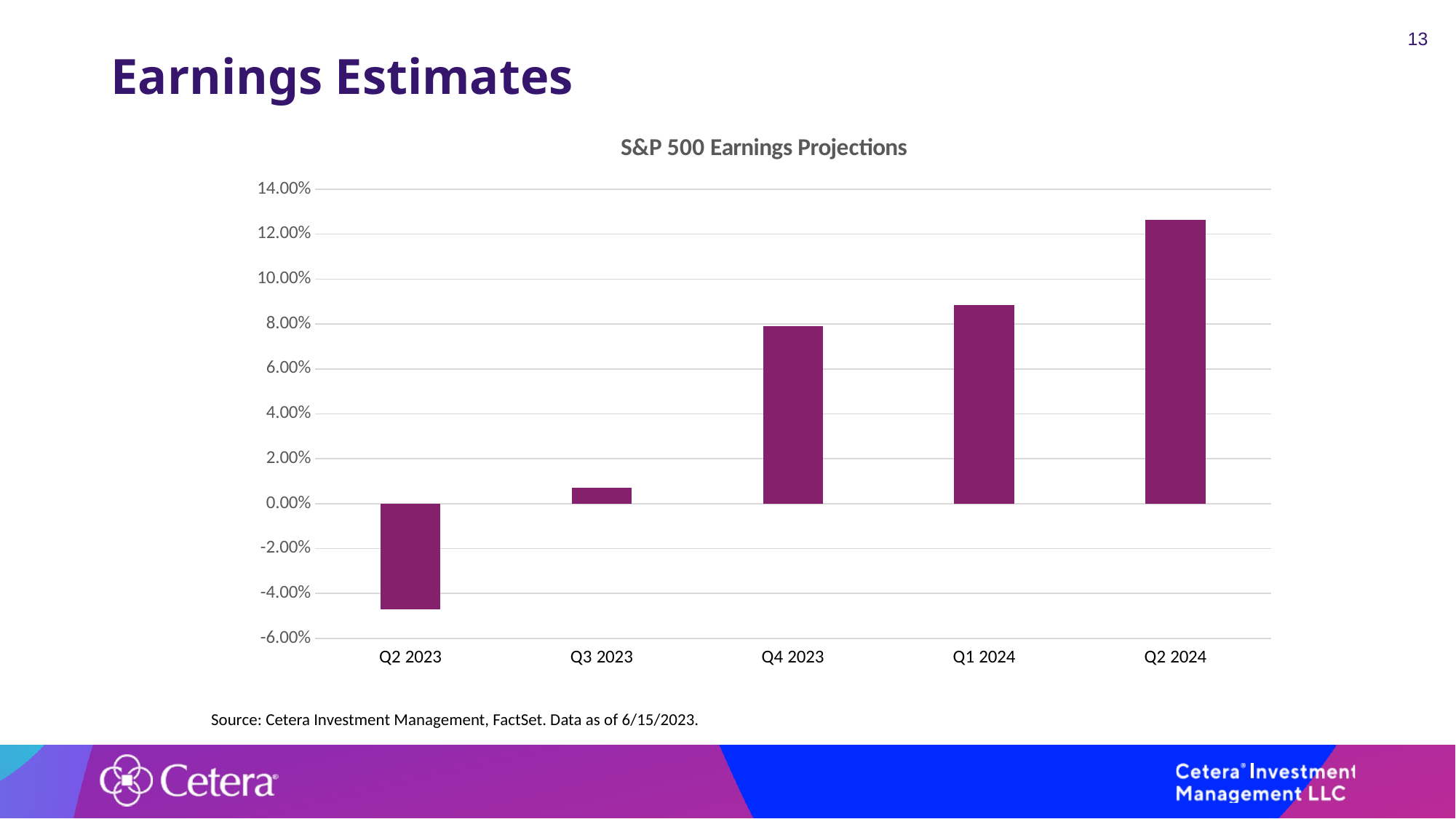
Is the value for Q1 2024 greater or less than 8.00%? greater What type of chart is shown on the slide? bar chart How many quarters are shown on the x axis of the chart? 5 Is the value for Q2 2024 greater or less than 12.00%? greater What is the title of the chart? S&P 500 Earnings Projections Which quarter has the lowest projected earnings growth? Q2 2023 Do the projected earnings values rise or fall from Q2 2023 to Q2 2024? rise Is the value for Q3 2023 greater or less than 2.00%? less Which is larger, the value for Q1 2024 or the value for Q4 2023? Q1 2024 Which quarter has the highest projected earnings growth? Q2 2024